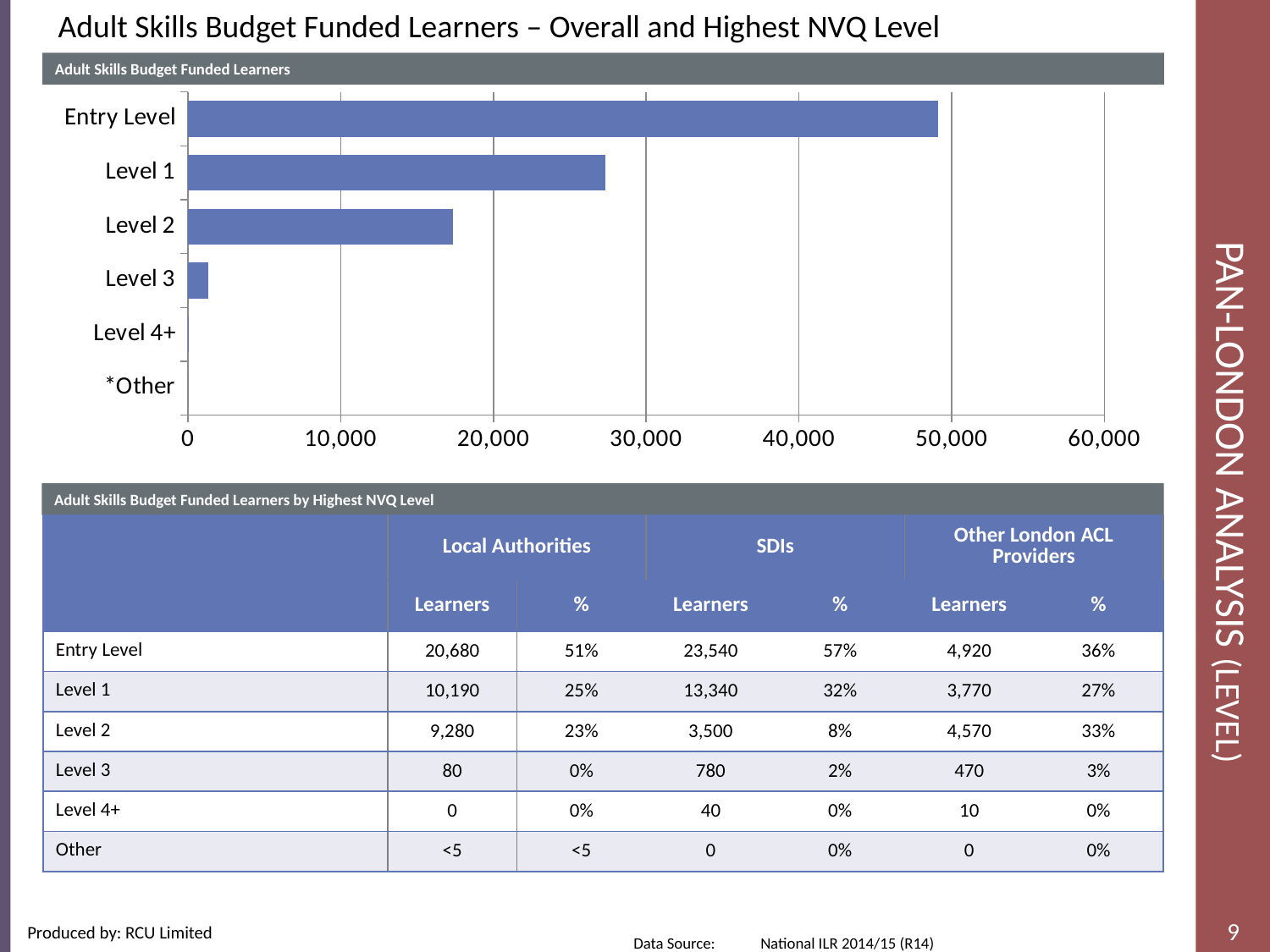
Which category has the highest value in the chart? Entry Level What kind of chart is shown on the slide? bar chart Is the value for Level 2 greater or less than 20,000? less Which is larger, the value for Level 1 or the value for Level 2? Level 1 Is the value for Level 3 greater or less than 10,000? less Is the value for Entry Level greater or less than 40,000? greater How many categories are shown on the chart's vertical axis? 6 What is the title of the chart? Adult Skills Budget Funded Learners Do the bar values rise or fall going down the chart from Entry Level to Level 4+? fall